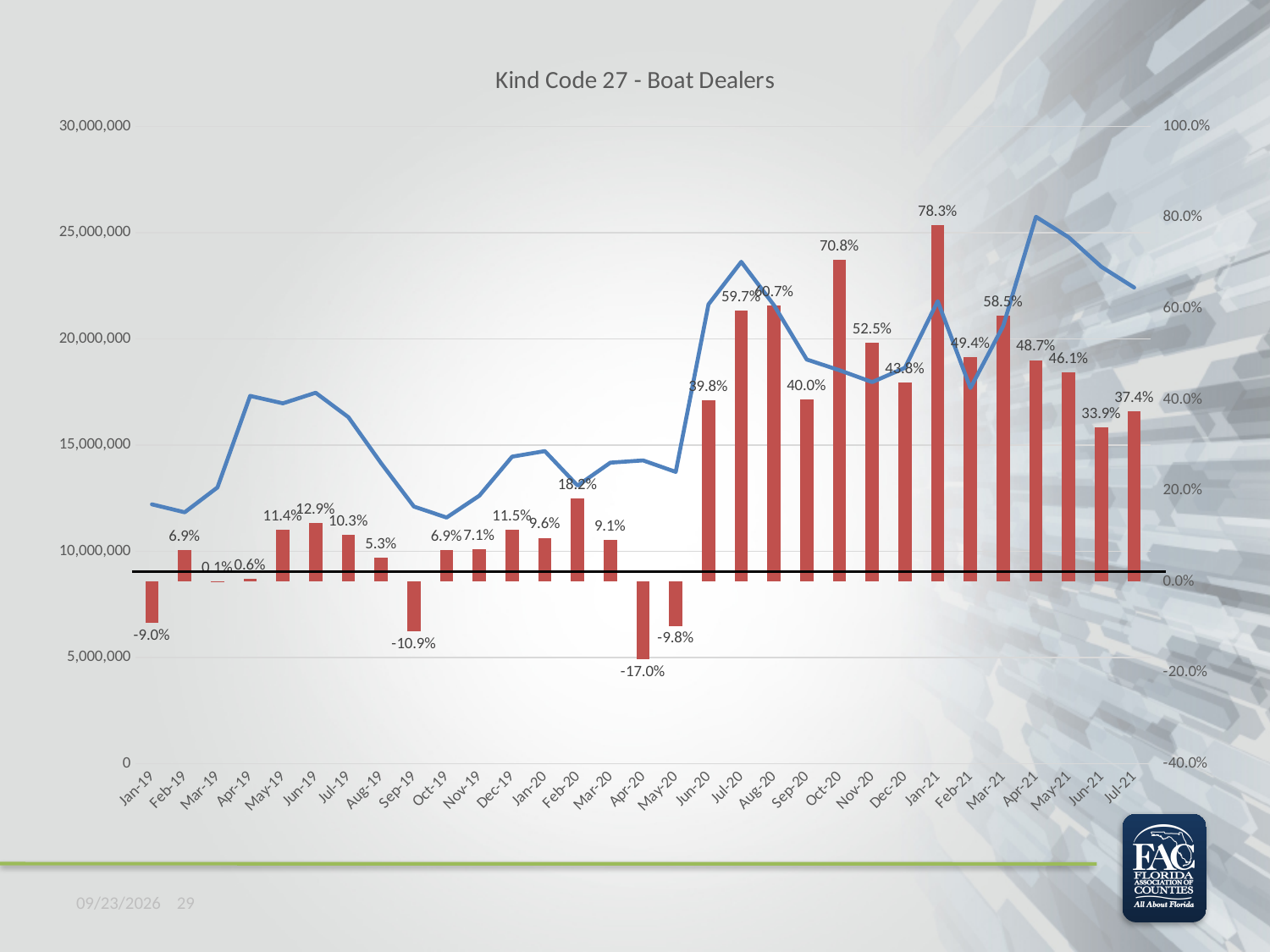
What is the percentage value shown for Apr-20? -17.0% What kind of chart is this? Combination bar and line chart Is the line value for Apr-21 on the left axis greater or less than 25,000,000? greater Which has the larger percentage value, Jul-20 or Aug-20? Aug-20 What is the percentage value shown for Jan-21? 78.3% What is the percentage value shown for Oct-20? 70.8% Which month has the lowest percentage bar? Apr-20 Which month has the highest percentage bar? Jan-21 Is the line value for Apr-20 on the left axis greater or less than 15,000,000? less What is the title of the chart? Kind Code 27 - Boat Dealers What is the difference between the percentage values for Jan-21 and Oct-20? 7.5% How many months are shown on the x axis? 31